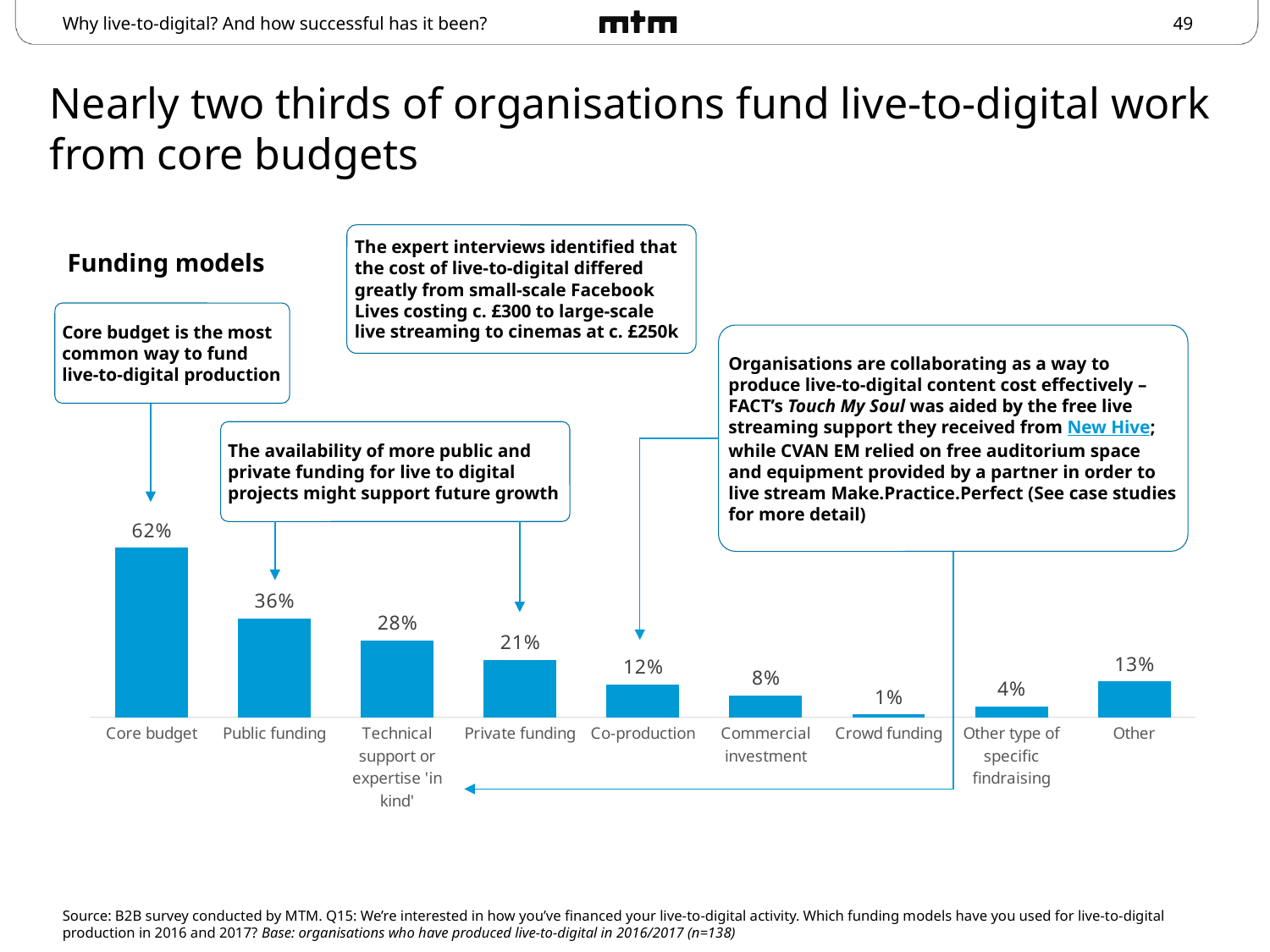
What is the value for Public funding? 36% What percentage of organisations use core budget as a funding model? 62% What is the value for Co-production? 12% Which is larger, Private funding or Technical support or expertise 'in kind'? Technical support or expertise 'in kind' Which funding model has the highest value? Core budget What is the title of the chart? Funding models What is the difference between Other and Other type of specific findraising? 9% What is the difference between Core budget and Public funding? 26% Which funding model has the lowest value? Crowd funding What is the value for Crowd funding? 1% What kind of chart is shown on the slide? Bar chart How many funding model categories are shown in the chart? 9